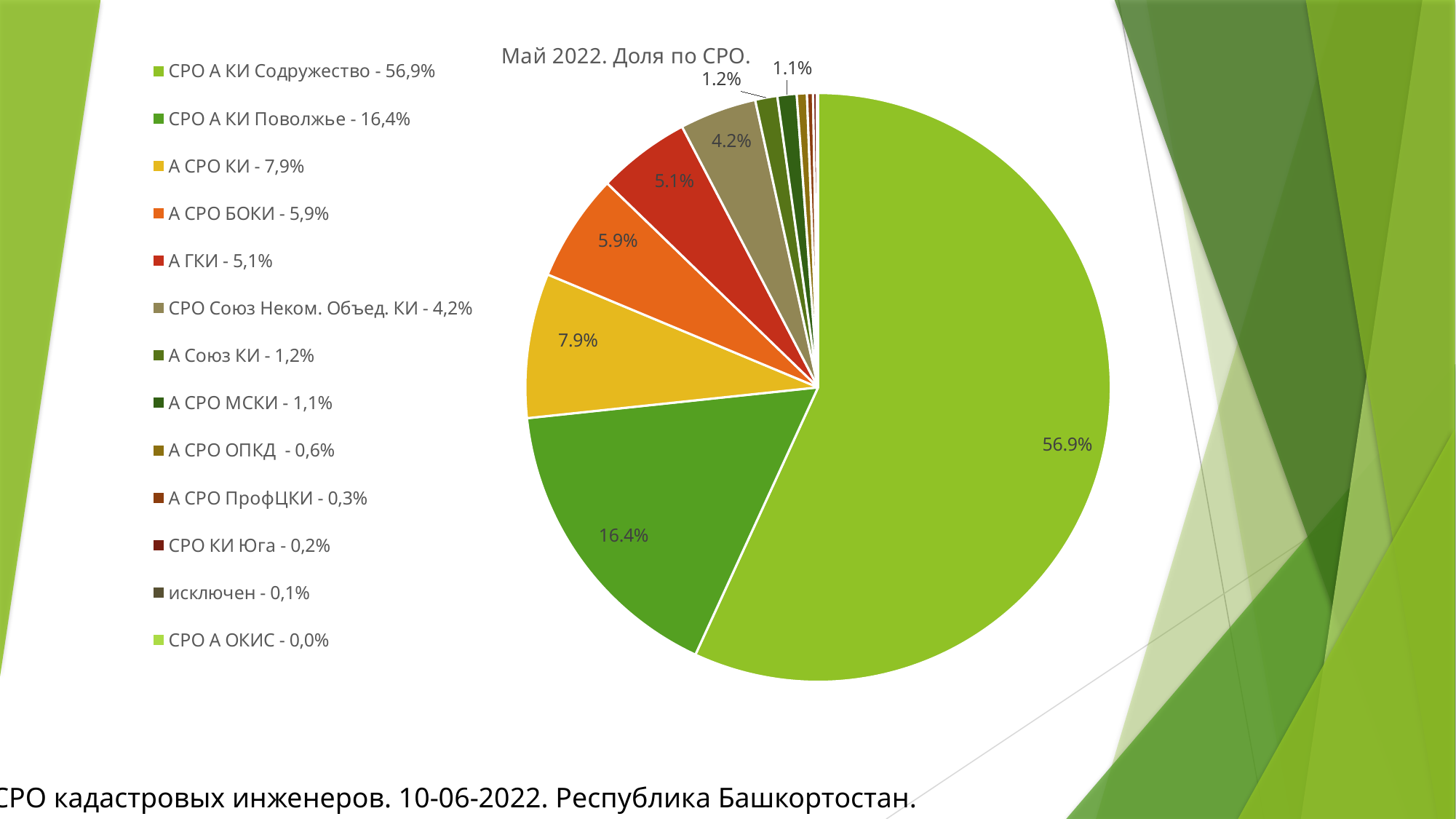
Which category has the smallest share according to the legend? СРО А ОКИС Which category has the largest slice of the pie? СРО А КИ Содружество What share of the pie does А СРО КИ have? 7.9% What is the difference in share between СРО А КИ Содружество and СРО А КИ Поволжье? 40.5% What share of the pie does СРО А КИ Поволжье have? 16.4% What share is listed in the legend for А СРО ОПКД? 0,6% What share of the pie does СРО А КИ Содружество have? 56.9% How many entries does the chart legend list? 13 Which has the larger share, А СРО КИ or А СРО БОКИ? А СРО КИ What is the title of the chart? Май 2022. Доля по СРО. What kind of chart is shown on the slide? pie chart